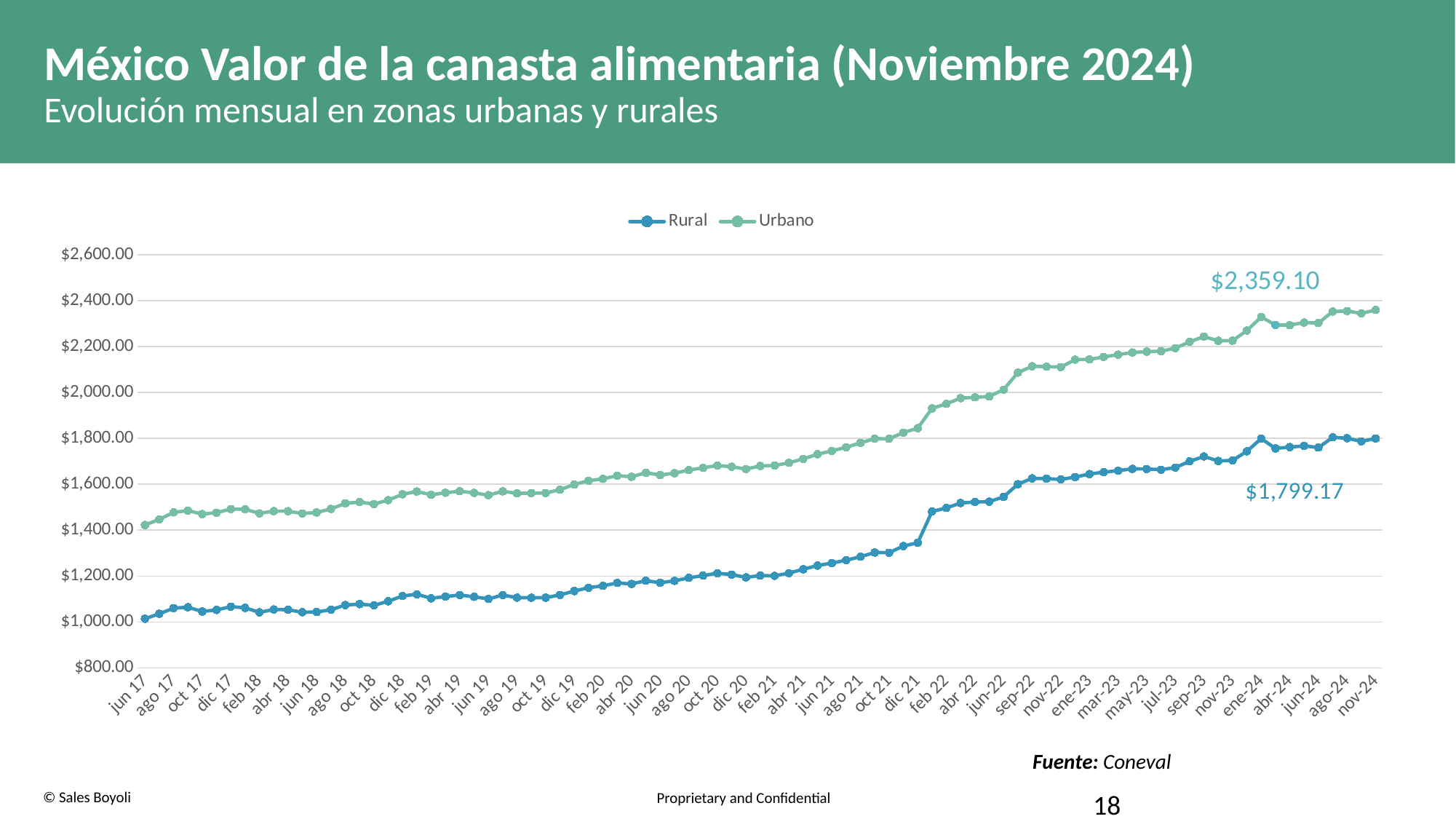
What are the two series named in the legend? Rural and Urbano In nov-24, which series has the larger value, Rural or Urbano? Urbano Is the Rural value for dic 21 greater or less than $1,400.00? less What is the value of the Rural series in nov-24? $1,799.17 What kind of chart is shown on the slide? Line chart Is the Urbano value for feb 22 greater or less than $1,800.00? greater Is the Rural value for jun 17 greater or less than $1,200.00? less Do the values of the Urbano series generally rise or fall from jun 17 to nov-24? Rise How many series does the legend list? 2 What is the value of the Urbano series in nov-24? $2,359.10 At which month is the Rural series at its lowest value? jun 17 What is the difference between the Urbano and Rural values in nov-24? $559.93